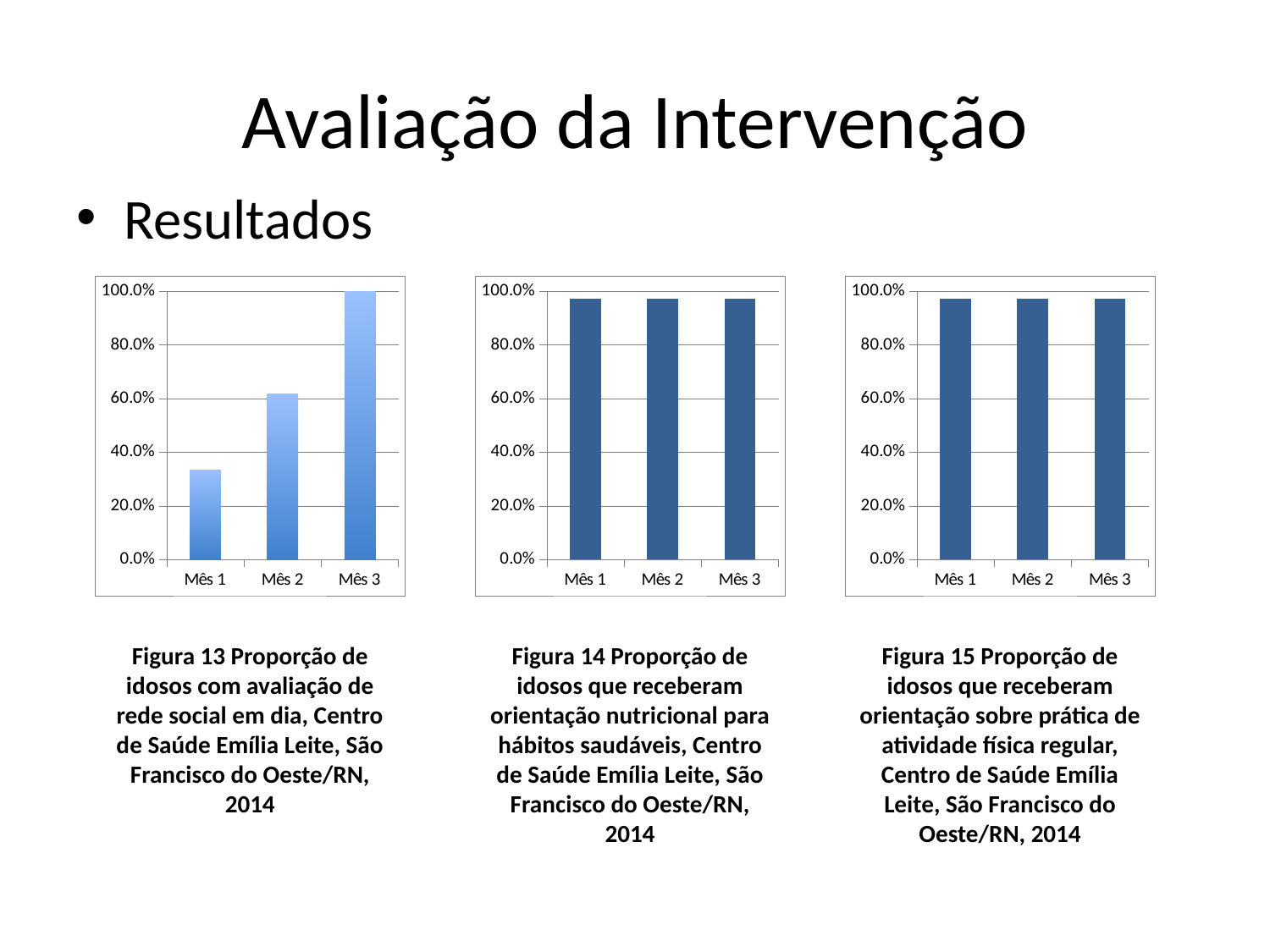
How many categories are shown on the x axis of the right chart (Figura 15)? 3 What kind of chart is the middle chart (Figura 14)? bar chart In the left chart (Figura 13), which is larger, the value for Mês 1 or the value for Mês 2? Mês 2 In the right chart (Figura 15), is the value for Mês 3 greater or less than 80.0%? greater In the left chart (Figura 13), which month has the highest value? Mês 3 In the left chart (Figura 13), is the value for Mês 1 greater or less than 40.0%? less In the left chart (Figura 13), what is the value for Mês 3? 100.0% In the left chart (Figura 13), which month has the lowest value? Mês 1 In the left chart (Figura 13), is the value for Mês 2 greater or less than 60.0%? greater How many charts are shown on the slide? 3 In the left chart (Figura 13), do the values rise or fall from Mês 1 to Mês 3? rise